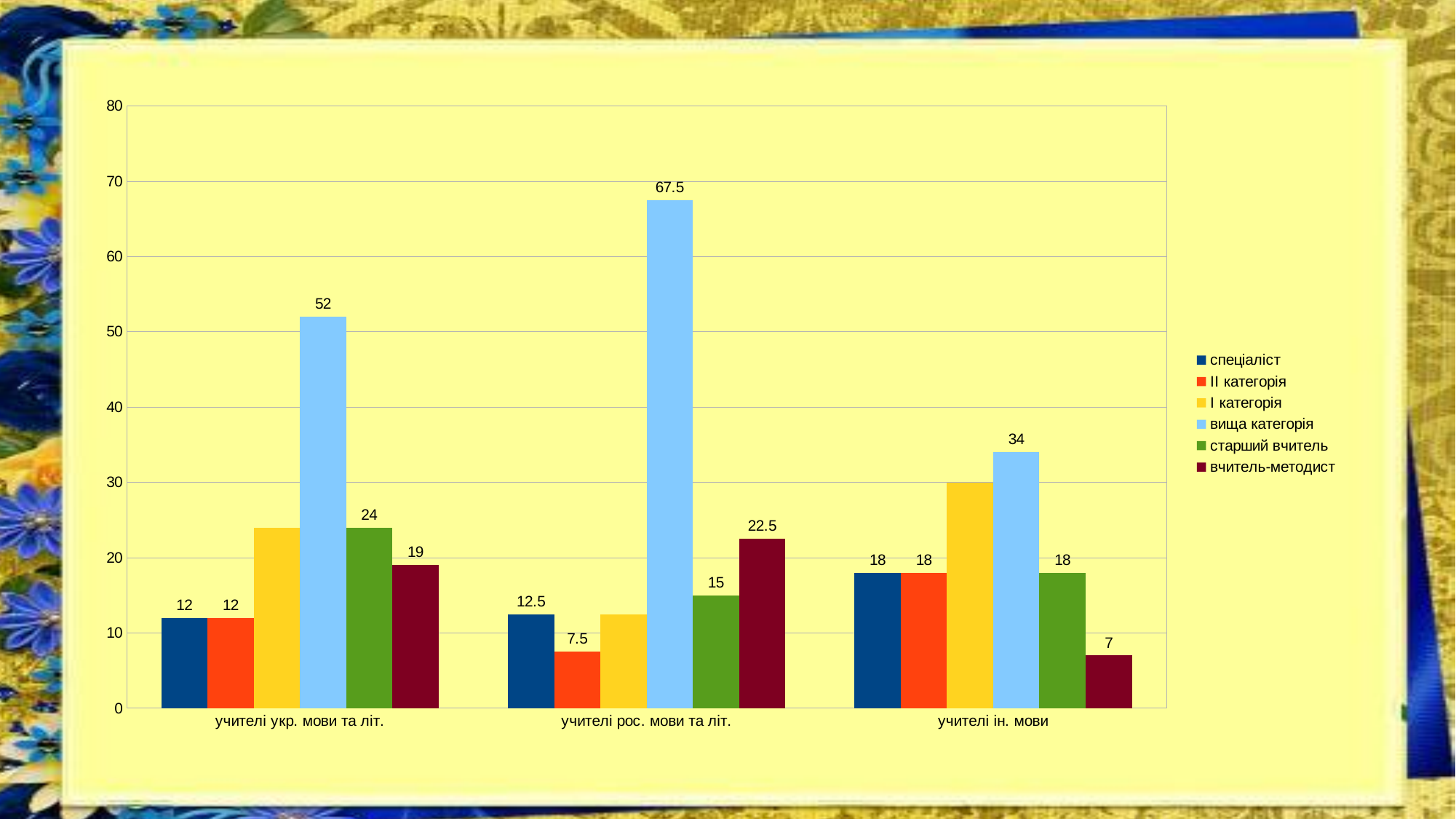
Is the value of I категорія for учителі укр. мови та літ. greater or less than 20? greater Which is larger: старший вчитель for учителі укр. мови та літ. or вчитель-методист for учителі укр. мови та літ.? старший вчитель What kind of chart is shown on the slide? bar chart What is the value of вища категорія for учителі рос. мови та літ.? 67.5 Which category has the highest value for вища категорія? учителі рос. мови та літ. Which category has the lowest value for вчитель-методист? учителі ін. мови What is the value of II категорія for учителі рос. мови та літ.? 7.5 How many series does the legend list? 6 What is the value of вчитель-методист for учителі ін. мови? 7 What colour represents вища категорія in the legend? light blue What is the difference between вища категорія for учителі рос. мови та літ. and for учителі укр. мови та літ.? 15.5 How many categories are shown on the x axis? 3